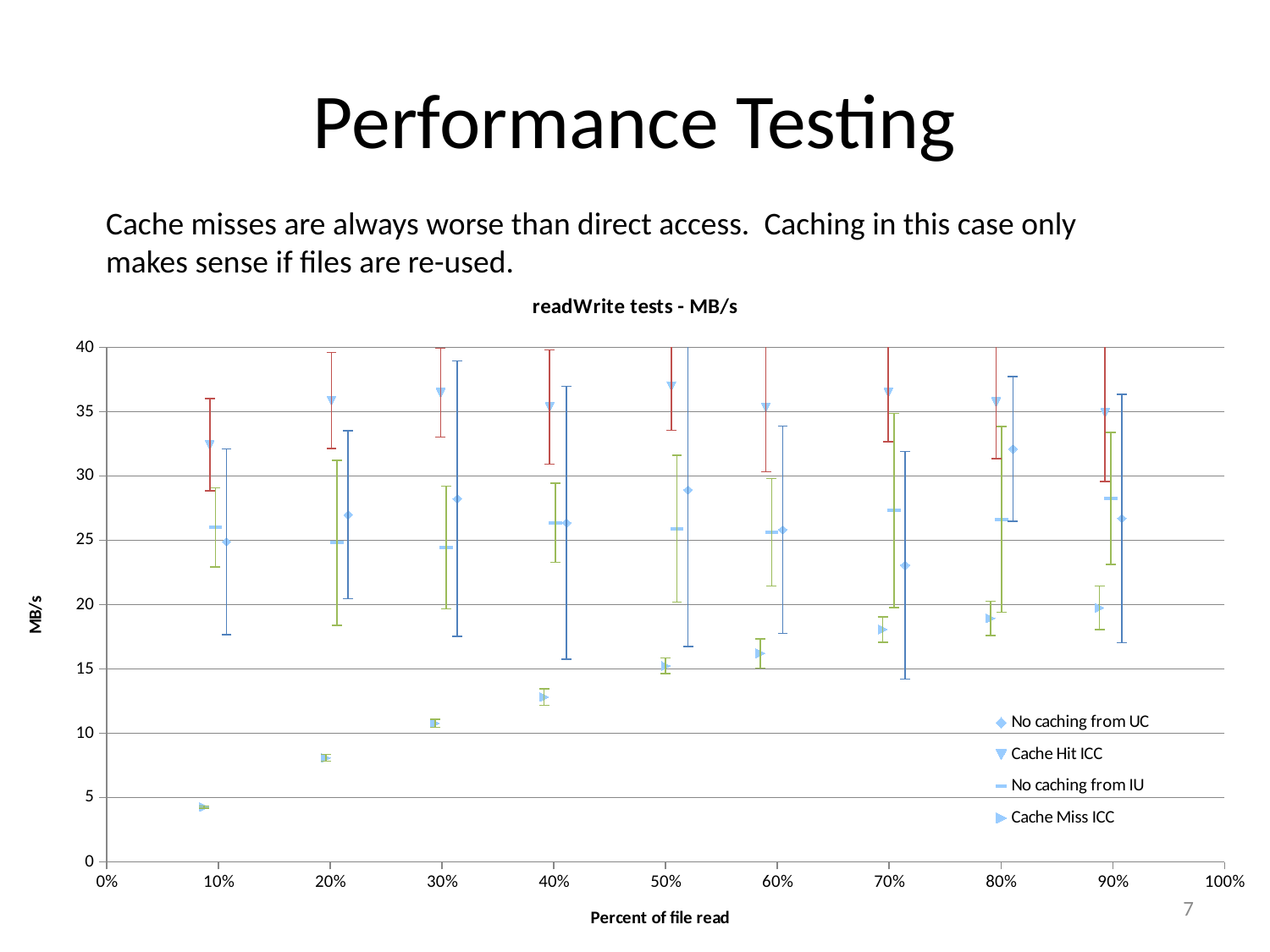
What kind of chart is shown on the slide? scatter chart How many series does the chart legend list? 4 Is the value for Cache Hit ICC at 50% greater or less than 35? greater Is the value for No caching from UC at 80% greater or less than 30? greater What is the label of the x axis of the chart? Percent of file read Is the value for No caching from IU at 10% greater or less than 30? less Which series has the lowest value at 10%? Cache Miss ICC At 10%, which is larger: Cache Hit ICC or Cache Miss ICC? Cache Hit ICC What is the title of the chart? readWrite tests - MB/s Do the values for Cache Miss ICC rise or fall as the percent of file read increases? rise